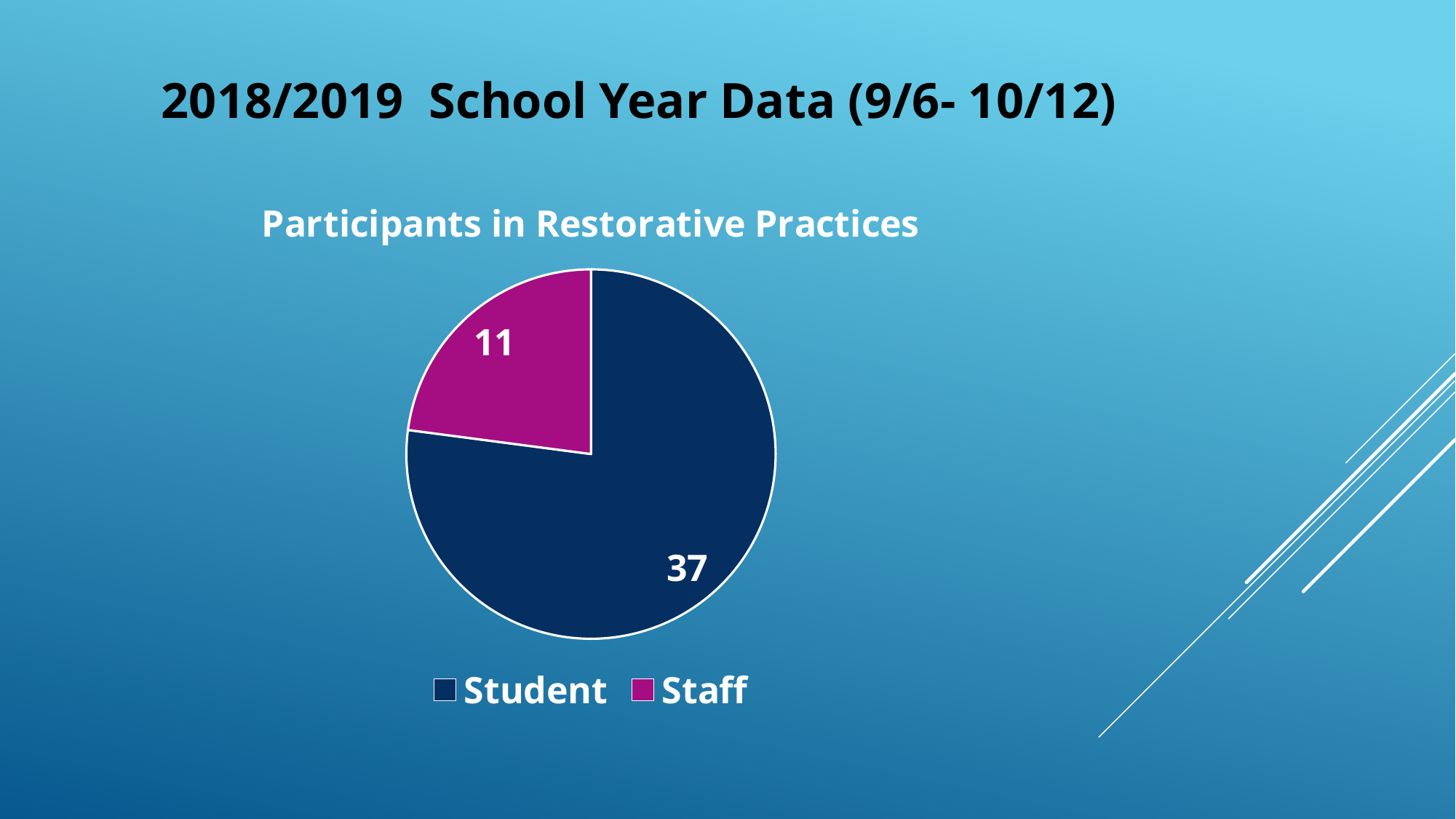
Which is larger, the value for Student or the value for Staff? Student What kind of chart is shown on the slide? Pie chart What is the title of the chart? Participants in Restorative Practices What is the value for Staff in the Participants in Restorative Practices chart? 11 How many categories does the pie chart show? 2 What colour is the Staff slice in the pie chart? Magenta What is the total number of participants shown in the pie chart? 48 Which category has the smallest slice in the pie chart? Staff What is the value for Student in the Participants in Restorative Practices chart? 37 How many entries does the legend list? 2 Which category has the largest slice in the pie chart? Student What is the difference between the Student and Staff values? 26